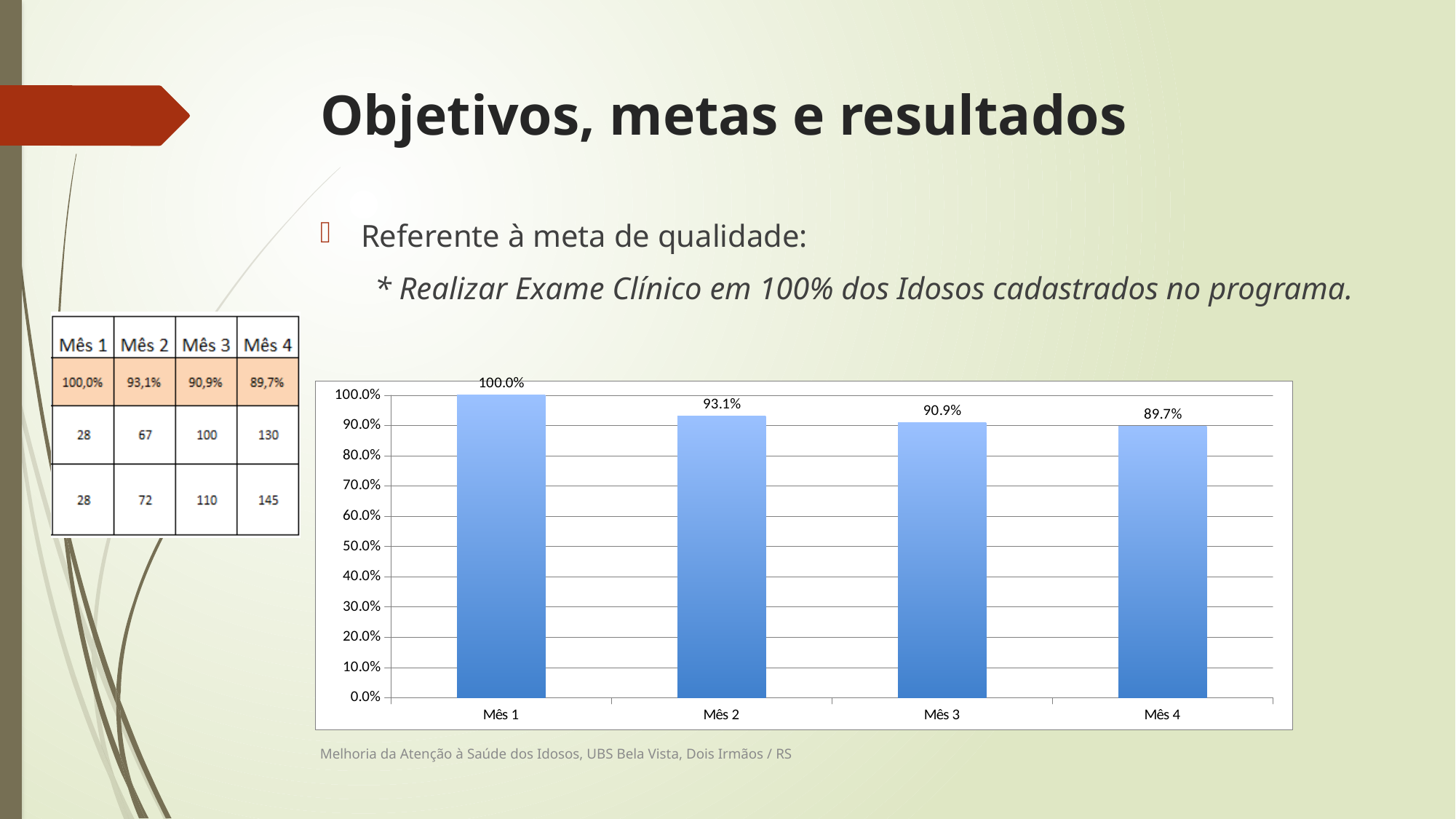
What is the value for Mês 4? 89.7% What is the difference between the values for Mês 2 and Mês 3? 2.2% Which month has the lowest value? Mês 4 Which month has the highest value? Mês 1 What kind of chart is shown on the slide? Bar chart What is the difference between the values for Mês 1 and Mês 4? 10.3% What is the value for Mês 3? 90.9% Which is larger, the value for Mês 2 or the value for Mês 4? Mês 2 What is the value for Mês 2? 93.1% Do the values rise or fall from Mês 1 to Mês 4? Fall How many months are shown on the x axis of the chart? 4 What is the value for Mês 1? 100.0%